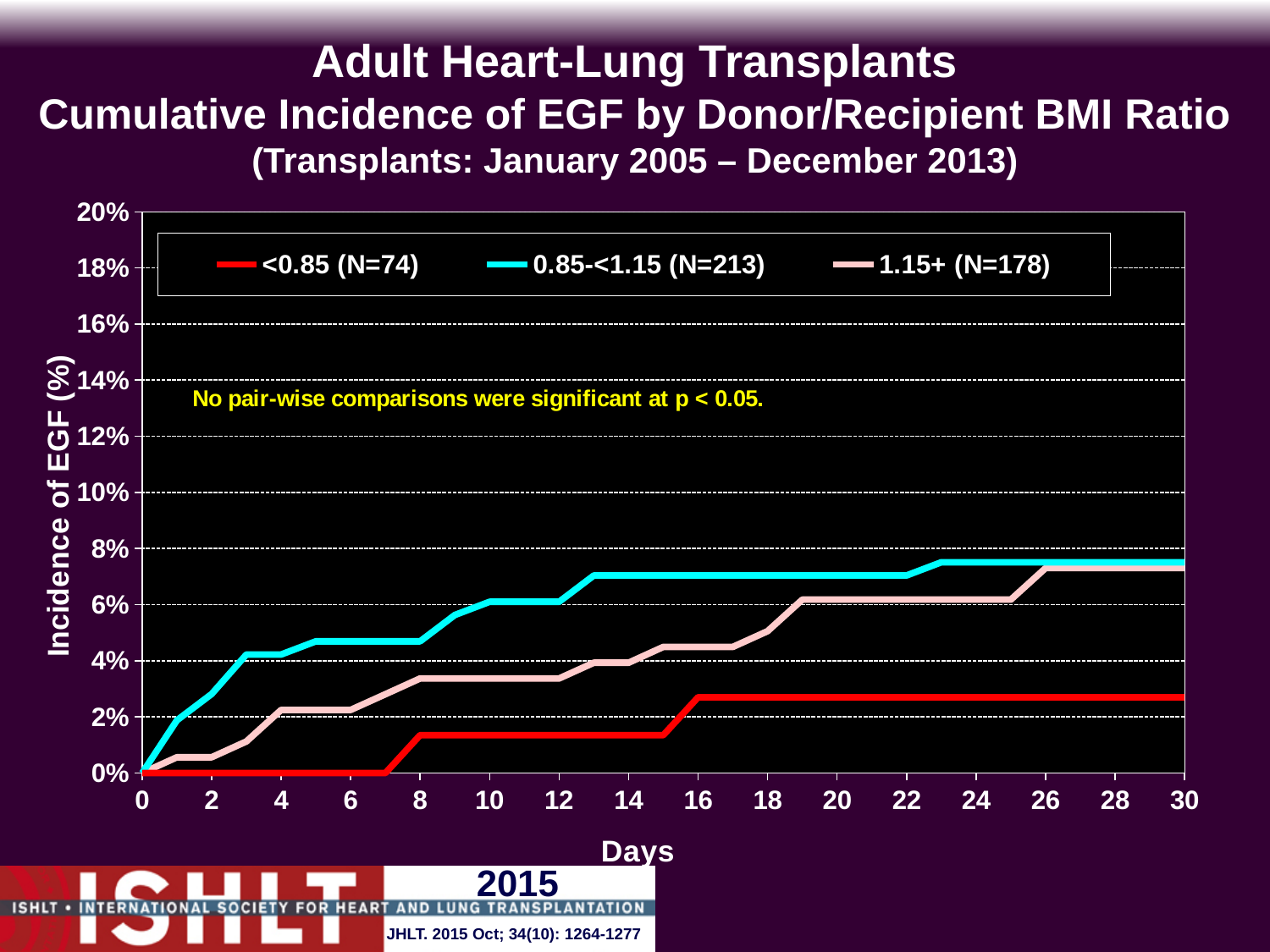
Which series has the highest cumulative incidence of EGF at day 10? 0.85-<1.15 (N=213) Is the incidence of EGF for the <0.85 (N=74) series at day 30 greater or less than 4%? less Is the incidence of EGF for the <0.85 (N=74) series at day 8 greater or less than 2%? less Is the incidence of EGF for the 1.15+ (N=178) series at day 10 greater or less than 4%? less What kind of chart is shown on the slide? line chart Which series has the lowest cumulative incidence of EGF across the 30 days? <0.85 (N=74) What is the sample size (N) shown in the legend for the 1.15+ series? 178 Do the lines rise or fall as the number of days increases? rise At day 30, which series has the larger incidence of EGF: <0.85 (N=74) or 0.85-<1.15 (N=213)? 0.85-<1.15 (N=213) How many series does the legend list? 3